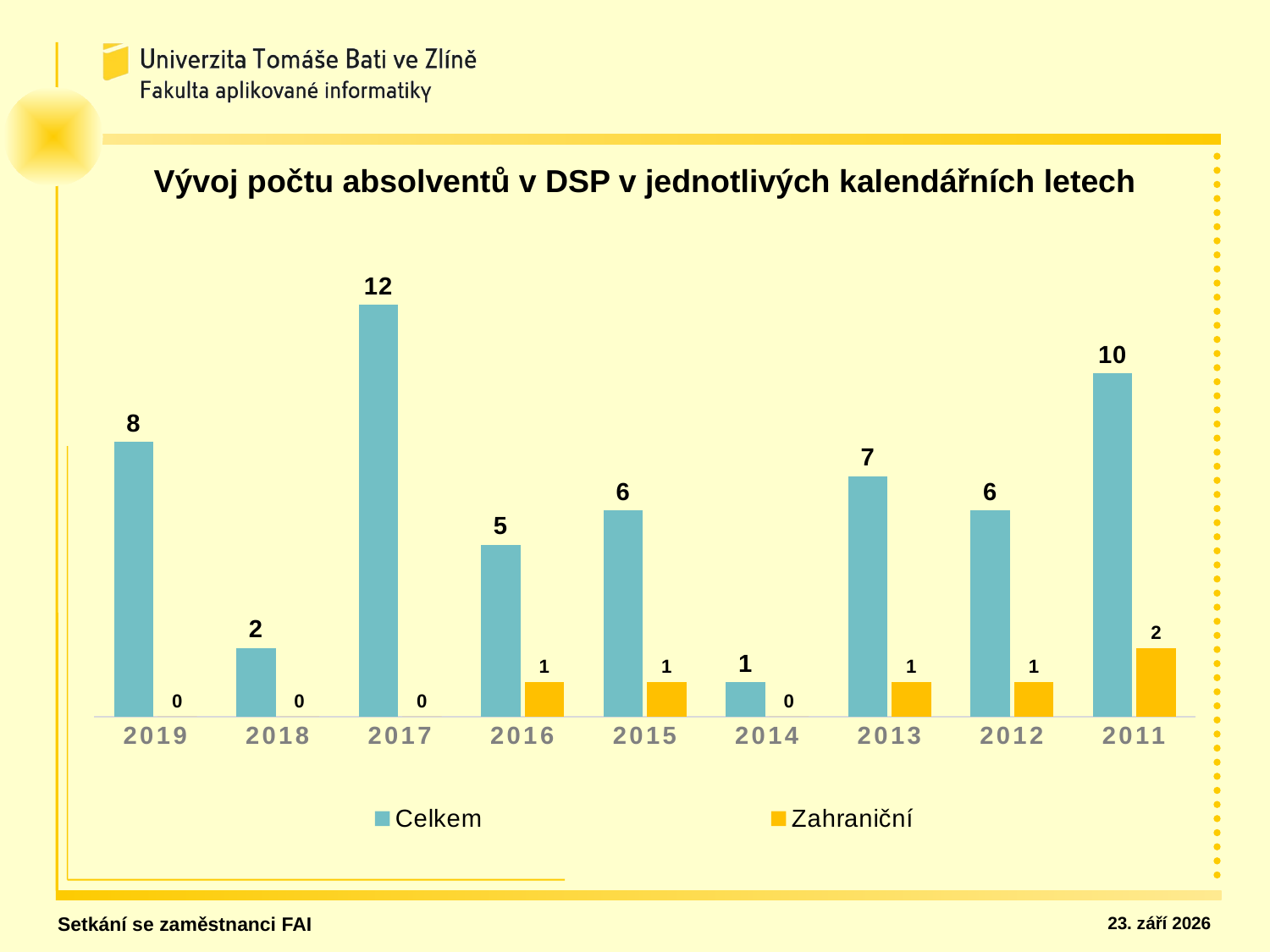
Which year has the lowest Celkem value? 2014 What is the title of the chart? Vývoj počtu absolventů v DSP v jednotlivých kalendářních letech What is the Celkem value for 2014? 1 How many years are shown on the x axis? 9 How many series does the legend list? 2 What is the difference between the Celkem values for 2017 and 2011? 2 Which year has the highest Celkem value? 2017 What is the Celkem value for 2017? 12 What is the Zahraniční value for 2011? 2 Which is larger, the Celkem value for 2019 or for 2013? 2019 What is the Zahraniční value for 2018? 0 What kind of chart is shown on the slide? bar chart